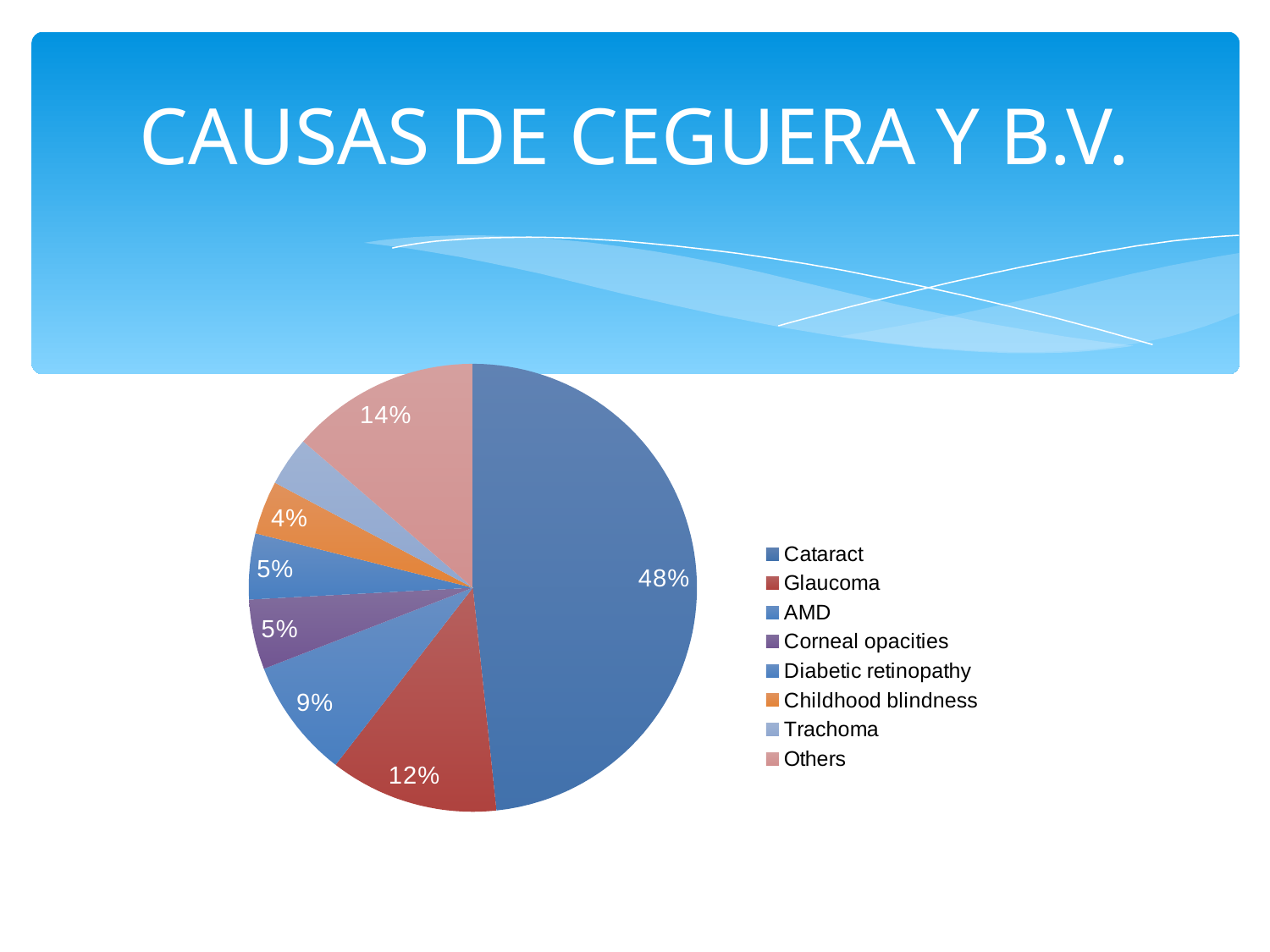
What share of the pie does Cataract account for? 48% What is the title of the slide containing the chart? CAUSAS DE CEGUERA Y B.V. What kind of chart is shown on the slide? Pie chart How many categories does the legend list? 8 What is the difference in percentage points between Cataract and Glaucoma? 36 What percentage is shown for Childhood blindness? 4% Which is larger, the share for Others or the share for AMD? Others What percentage is shown for Others? 14% What percentage is shown for AMD? 9% Which category has the largest slice of the pie? Cataract Which is larger, the share for Glaucoma or the share for Childhood blindness? Glaucoma What percentage is shown for Glaucoma? 12%